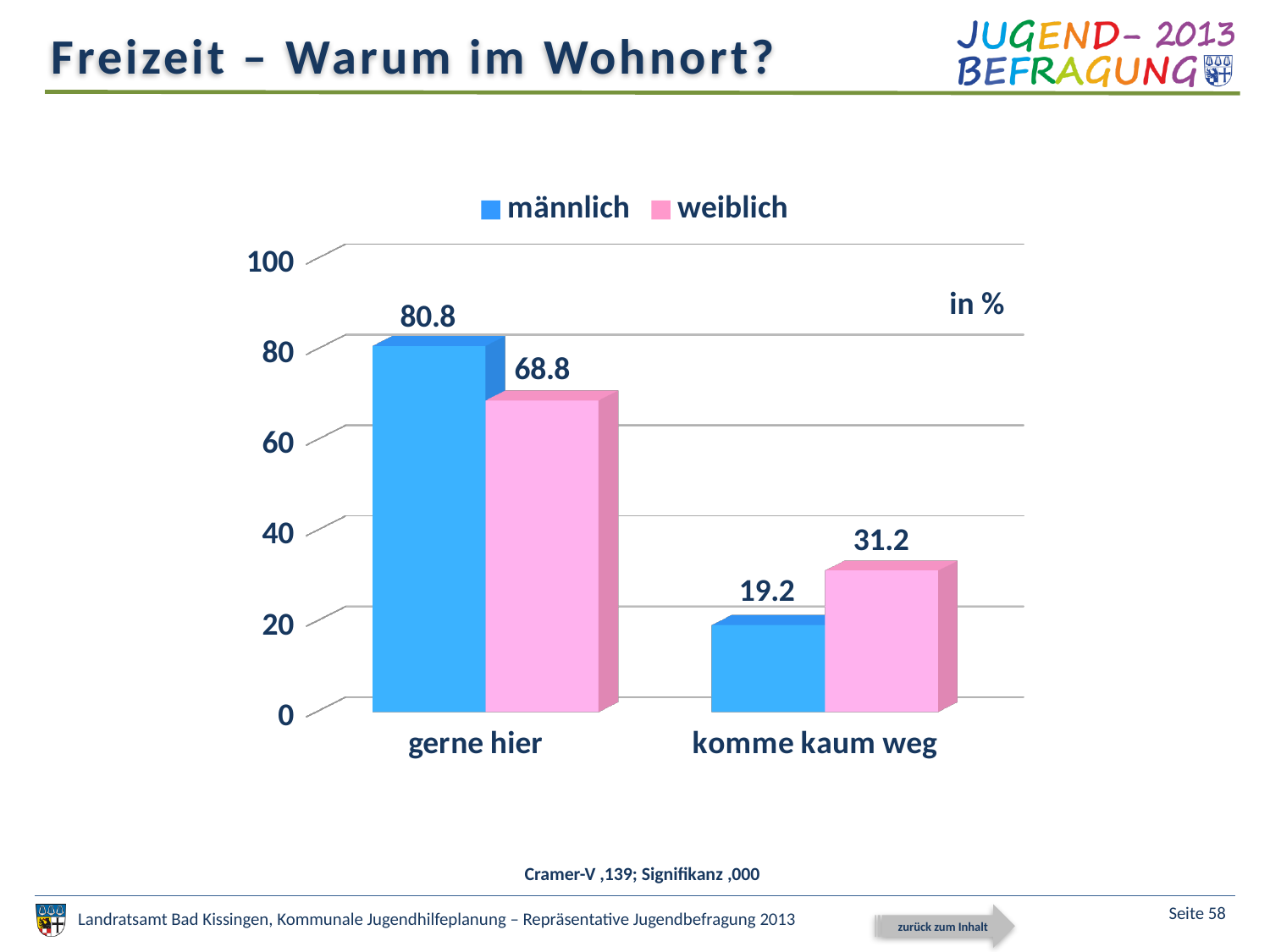
What is the difference between the männlich and weiblich values for 'gerne hier'? 12 What is the value for weiblich in the 'gerne hier' category? 68.8 What is the difference between the weiblich and männlich values for 'komme kaum weg'? 12 What is the value for männlich in the 'gerne hier' category? 80.8 How many categories are shown on the x axis? 2 Which category has the lowest value for weiblich? komme kaum weg What is the value for männlich in the 'komme kaum weg' category? 19.2 What kind of chart is shown on the slide? bar chart What is the value for weiblich in the 'komme kaum weg' category? 31.2 Which category has the highest value for männlich? gerne hier How many series does the legend list? 2 Which is larger for 'komme kaum weg': männlich or weiblich? weiblich